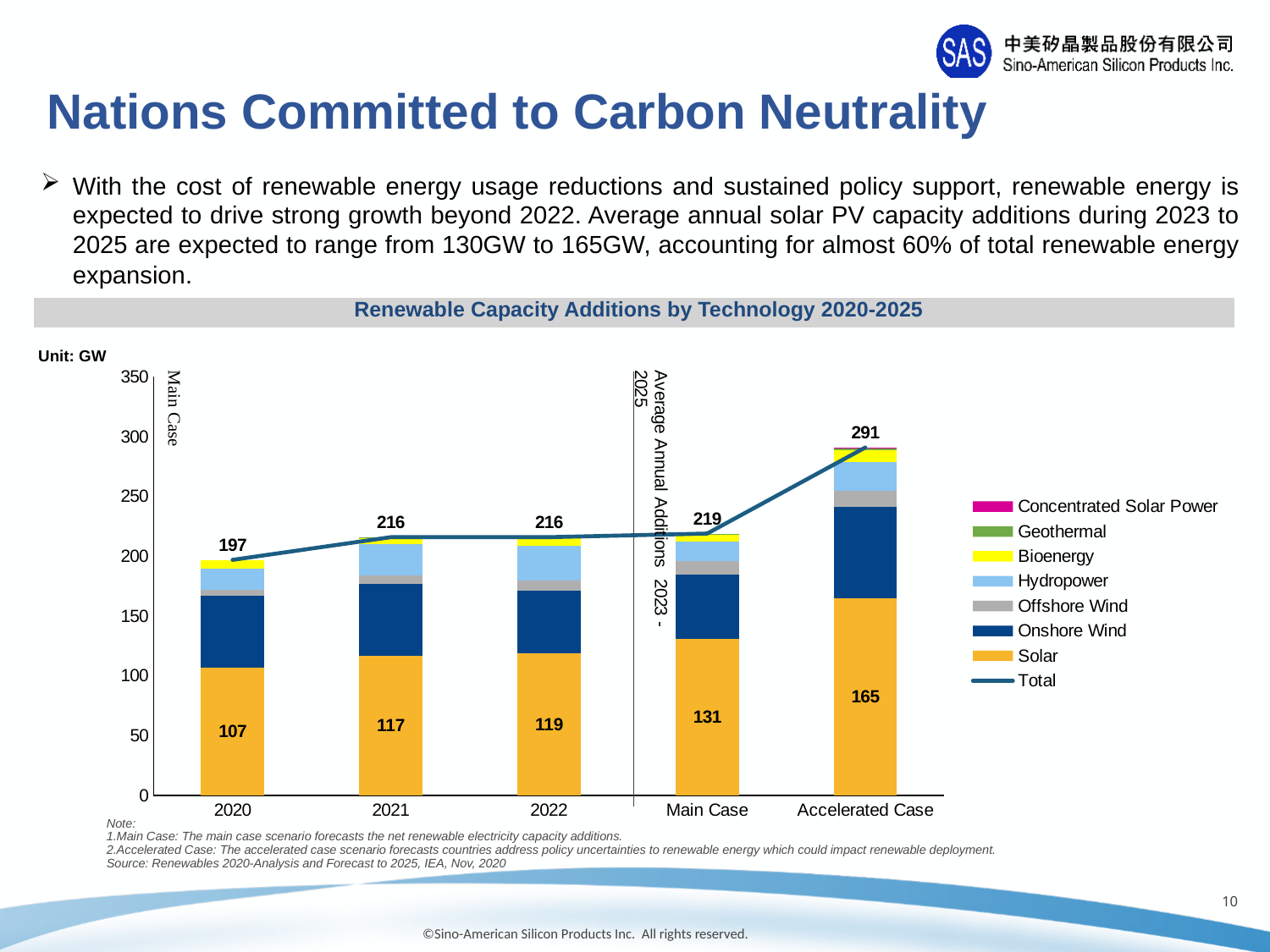
What is the Total value for the Accelerated Case? 291 What is the difference between the Total values for the Accelerated Case and the Main Case? 72 How many entries does the legend list? 8 How many categories are shown on the x axis? 5 Which category has the lowest Solar value? 2020 What is the Solar value for the Main Case? 131 Which is larger, the Solar value for the Accelerated Case or the Solar value for 2022? Accelerated Case What is the Solar value for 2020? 107 What is the unit of the values shown in the chart? GW Which category has the highest Total value? Accelerated Case Is the Onshore Wind segment for the Accelerated Case greater or less than 50? greater What is the difference between the Solar values for 2022 and 2021? 2